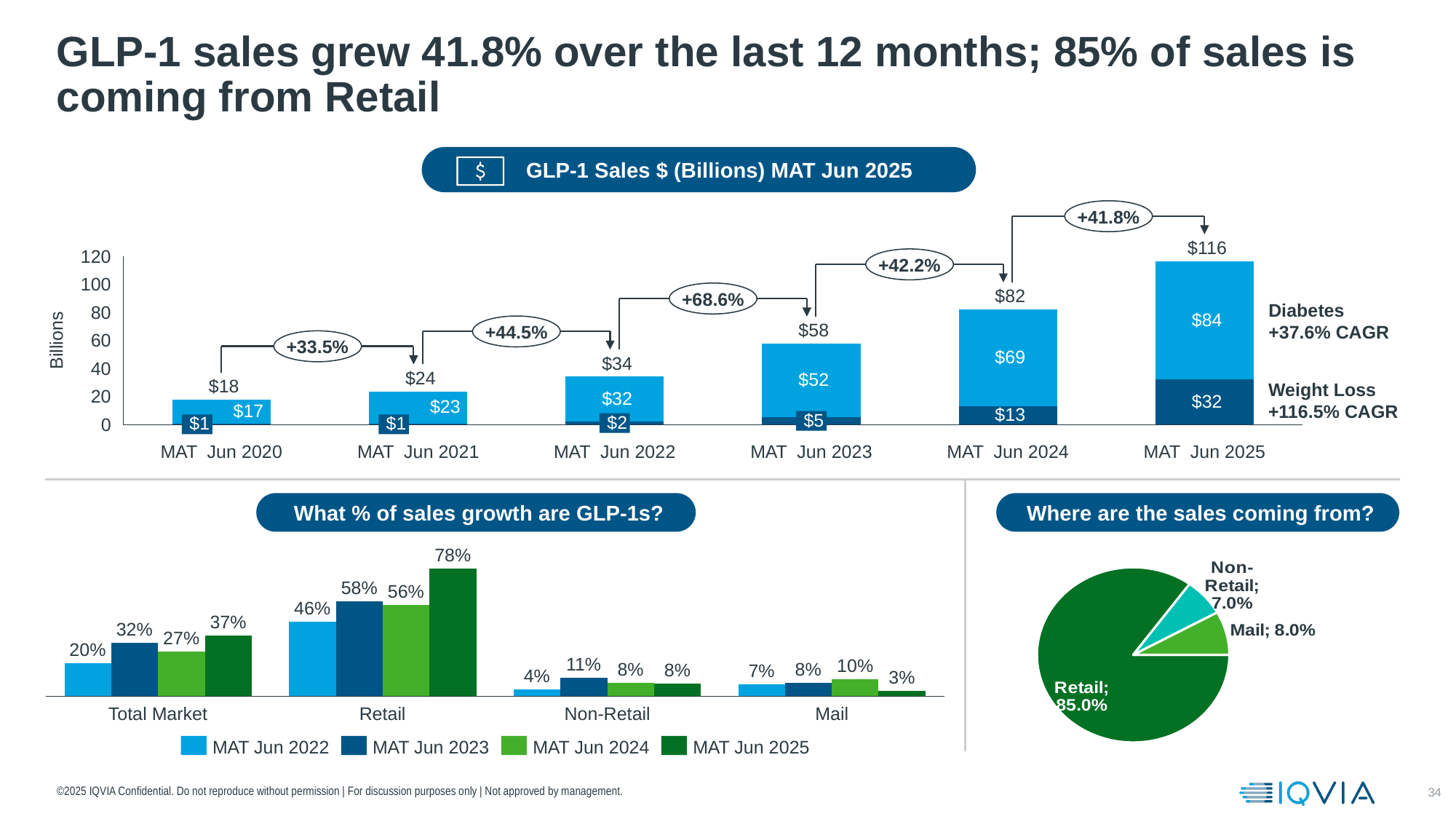
In the 'What % of sales growth are GLP-1s?' chart, which category has the highest value for MAT Jun 2025? Retail In the 'GLP-1 Sales $ (Billions) MAT Jun 2025' chart, what is the difference between the total for MAT Jun 2025 and the total for MAT Jun 2024? $34 In the 'What % of sales growth are GLP-1s?' chart, how many series does the legend list? 4 In the 'GLP-1 Sales $ (Billions) MAT Jun 2025' chart, what is the Diabetes value for MAT Jun 2023? $52 In the 'GLP-1 Sales $ (Billions) MAT Jun 2025' chart, how many MAT periods are shown on the x axis? 6 In the 'What % of sales growth are GLP-1s?' chart, which is larger for Total Market: MAT Jun 2023 or MAT Jun 2024? MAT Jun 2023 In the 'What % of sales growth are GLP-1s?' chart, what is the Retail value for MAT Jun 2025? 78% In the 'GLP-1 Sales $ (Billions) MAT Jun 2025' chart, what is the Weight Loss value for MAT Jun 2024? $13 In the 'GLP-1 Sales $ (Billions) MAT Jun 2025' chart, do total sales rise or fall from MAT Jun 2020 to MAT Jun 2025? Rise In the 'GLP-1 Sales $ (Billions) MAT Jun 2025' chart, what is the growth percentage shown between MAT Jun 2022 and MAT Jun 2023? +68.6% In the 'GLP-1 Sales $ (Billions) MAT Jun 2025' chart, what is the total sales value for MAT Jun 2025? $116 In the 'Where are the sales coming from?' chart, what share of sales comes from Mail? 8.0%